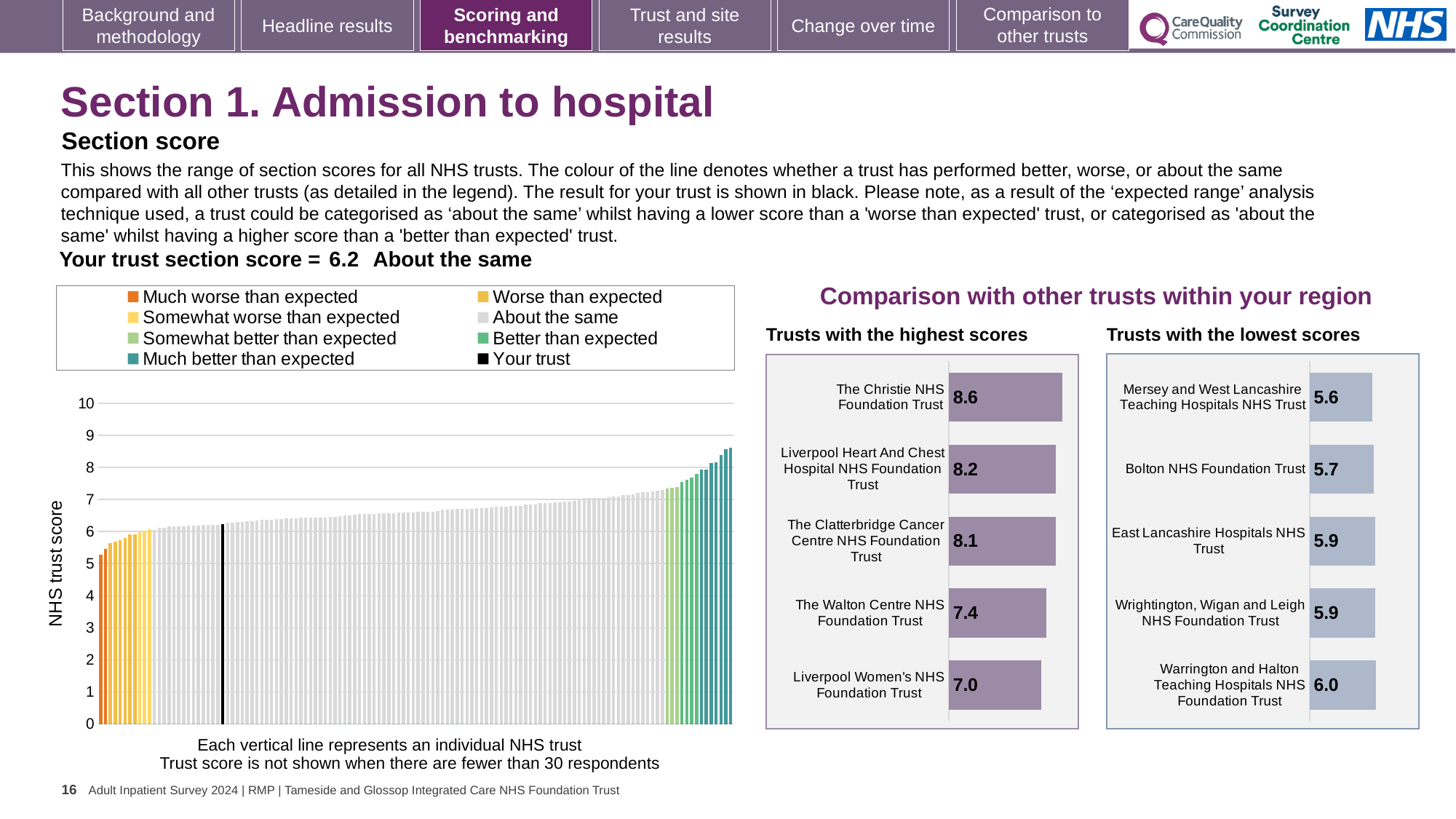
On the 'Trusts with the lowest scores' chart, what is the score for Bolton NHS Foundation Trust? 5.7 On the 'Trusts with the lowest scores' chart, what is the difference between the scores of Warrington and Halton Teaching Hospitals NHS Foundation Trust and Mersey and West Lancashire Teaching Hospitals NHS Trust? 0.4 On the large NHS trust score chart on the left, is the value of the tallest bar greater or less than 8? greater On the 'Trusts with the highest scores' chart, which has the higher score: The Clatterbridge Cancer Centre NHS Foundation Trust or The Walton Centre NHS Foundation Trust? The Clatterbridge Cancer Centre NHS Foundation Trust On the 'Trusts with the highest scores' chart, what is the score for The Christie NHS Foundation Trust? 8.6 On the 'Trusts with the lowest scores' chart, which trust has the highest score shown? Warrington and Halton Teaching Hospitals NHS Foundation Trust On the 'Trusts with the highest scores' chart, which trust has the lowest score shown? Liverpool Women's NHS Foundation Trust On the 'Trusts with the highest scores' chart, what is the difference between the scores of The Christie NHS Foundation Trust and Liverpool Women's NHS Foundation Trust? 1.6 How many trusts are shown on the 'Trusts with the lowest scores' chart? 5 How many entries does the legend of the large NHS trust score chart on the left list? 8 What kind of chart is the 'Trusts with the highest scores' chart? Bar chart On the large NHS trust score chart on the left, what is the section score for your trust (shown in black)? 6.2